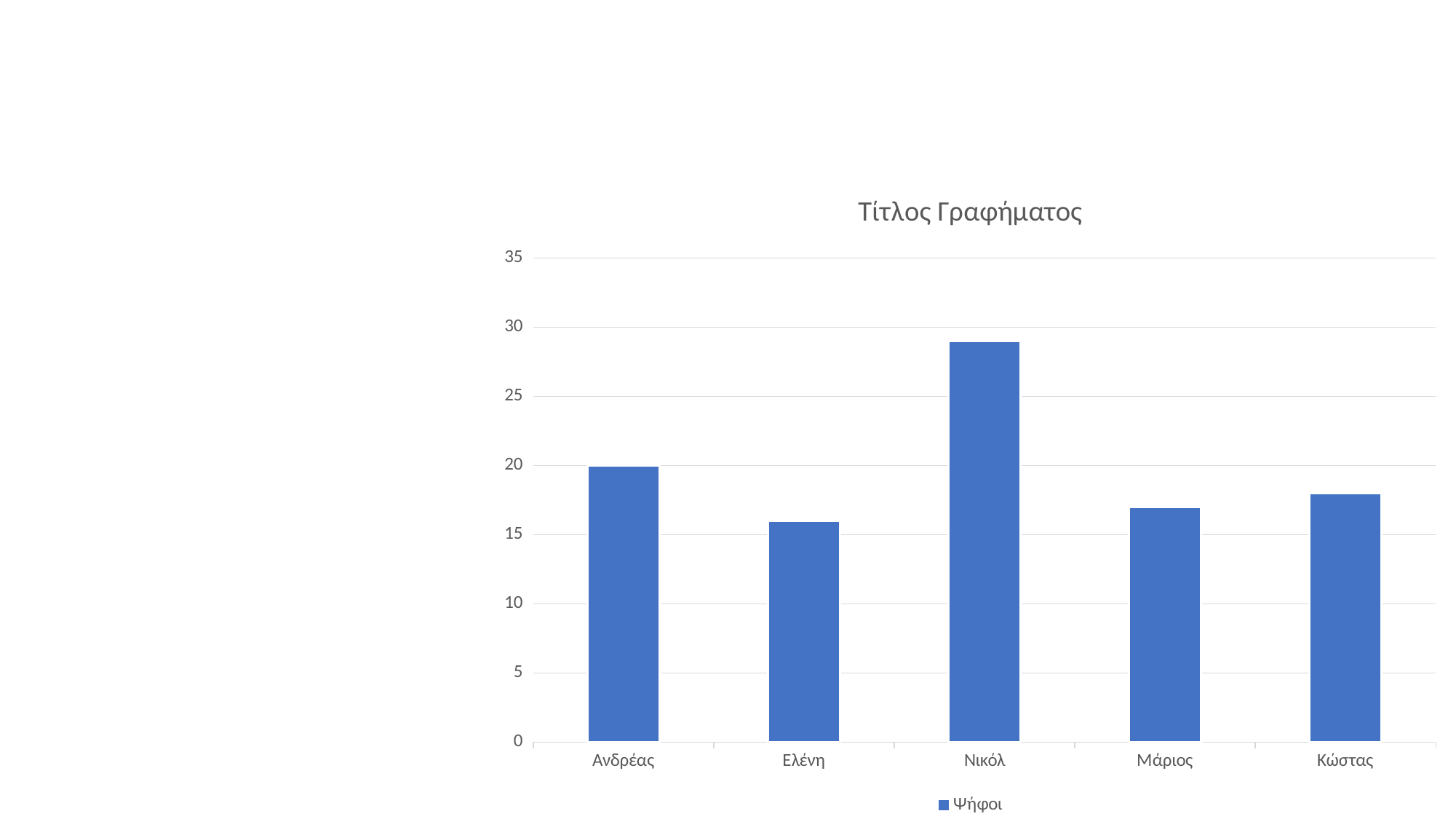
Which category has the highest value? Νικόλ Which category has the lowest value? Ελένη How many categories are shown on the x axis? 5 What is the title of the chart? Τίτλος Γραφήματος What is the name of the series shown in the legend? Ψήφοι Which is larger, the value for Ανδρέας or the value for Ελένη? Ανδρέας Is the value for Νικόλ greater or less than 25? greater Is the value for Ελένη greater or less than 20? less Which is larger, the value for Νικόλ or the value for Ανδρέας? Νικόλ What kind of chart is shown on the slide? bar chart How many series does the legend list? 1 Is the value for Κώστας greater or less than 15? greater